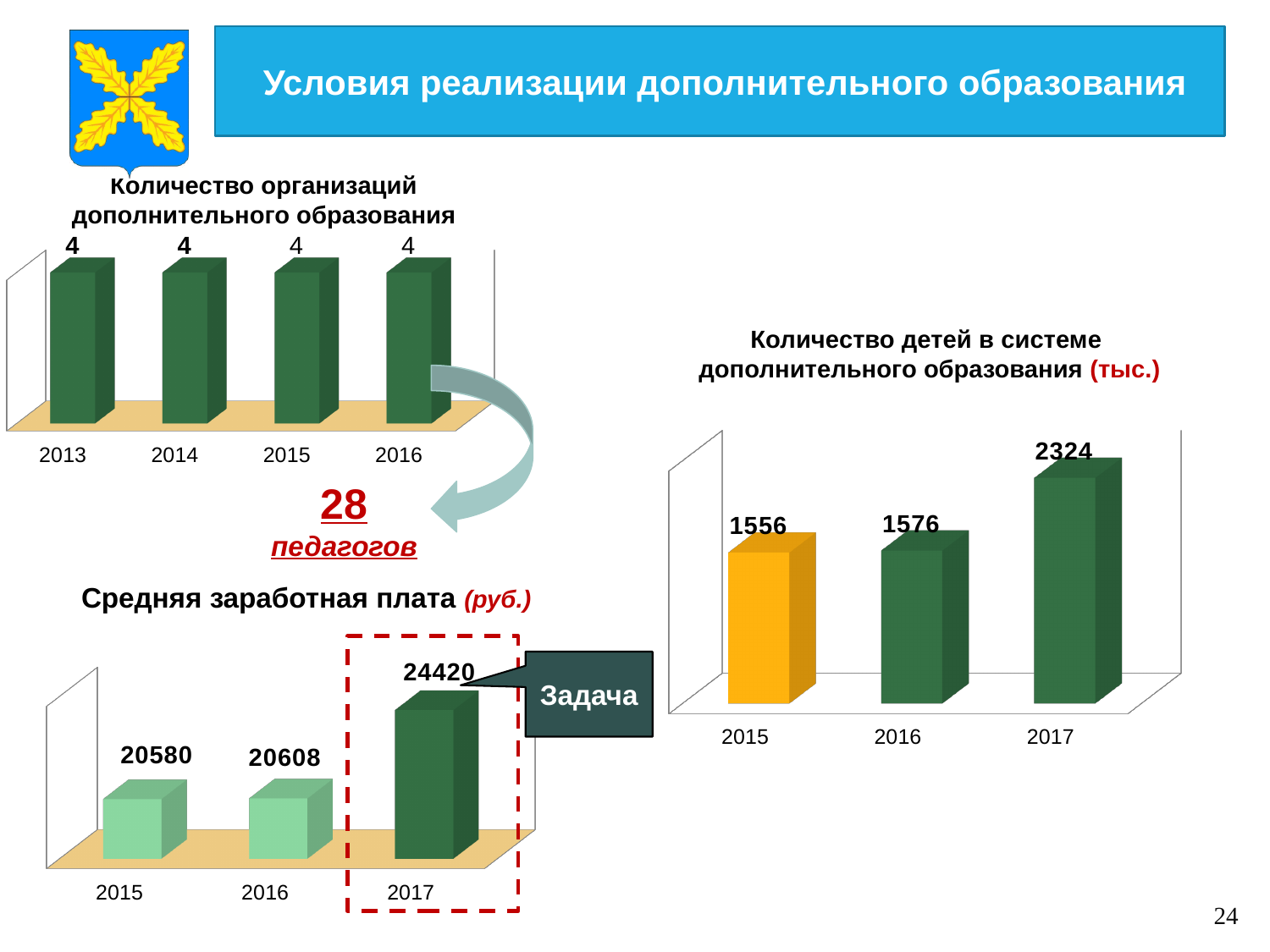
What type of chart is 'Количество детей в системе дополнительного образования (тыс.)'? bar chart In the chart 'Количество организаций дополнительного образования', what is the value for 2014? 4 In the chart 'Количество детей в системе дополнительного образования (тыс.)', do the values rise or fall from 2015 to 2017? rise In the chart 'Количество организаций дополнительного образования', do the values rise, fall or stay the same from 2013 to 2016? stay the same In the chart 'Средняя заработная плата (руб.)', which year has the highest value? 2017 In the chart 'Средняя заработная плата (руб.)', what is the value for 2015? 20580 In the chart 'Количество детей в системе дополнительного образования (тыс.)', what is the difference between the 2017 and 2015 values? 768 In the chart 'Средняя заработная плата (руб.)', what is the difference between the 2017 and 2016 values? 3812 In the chart 'Количество детей в системе дополнительного образования (тыс.)', what is the value for 2016? 1576 In the chart 'Средняя заработная плата (руб.)', what is the value for 2017? 24420 In the chart 'Количество детей в системе дополнительного образования (тыс.)', which year has the lowest value? 2015 How many categories (years) does the chart 'Количество организаций дополнительного образования' show? 4